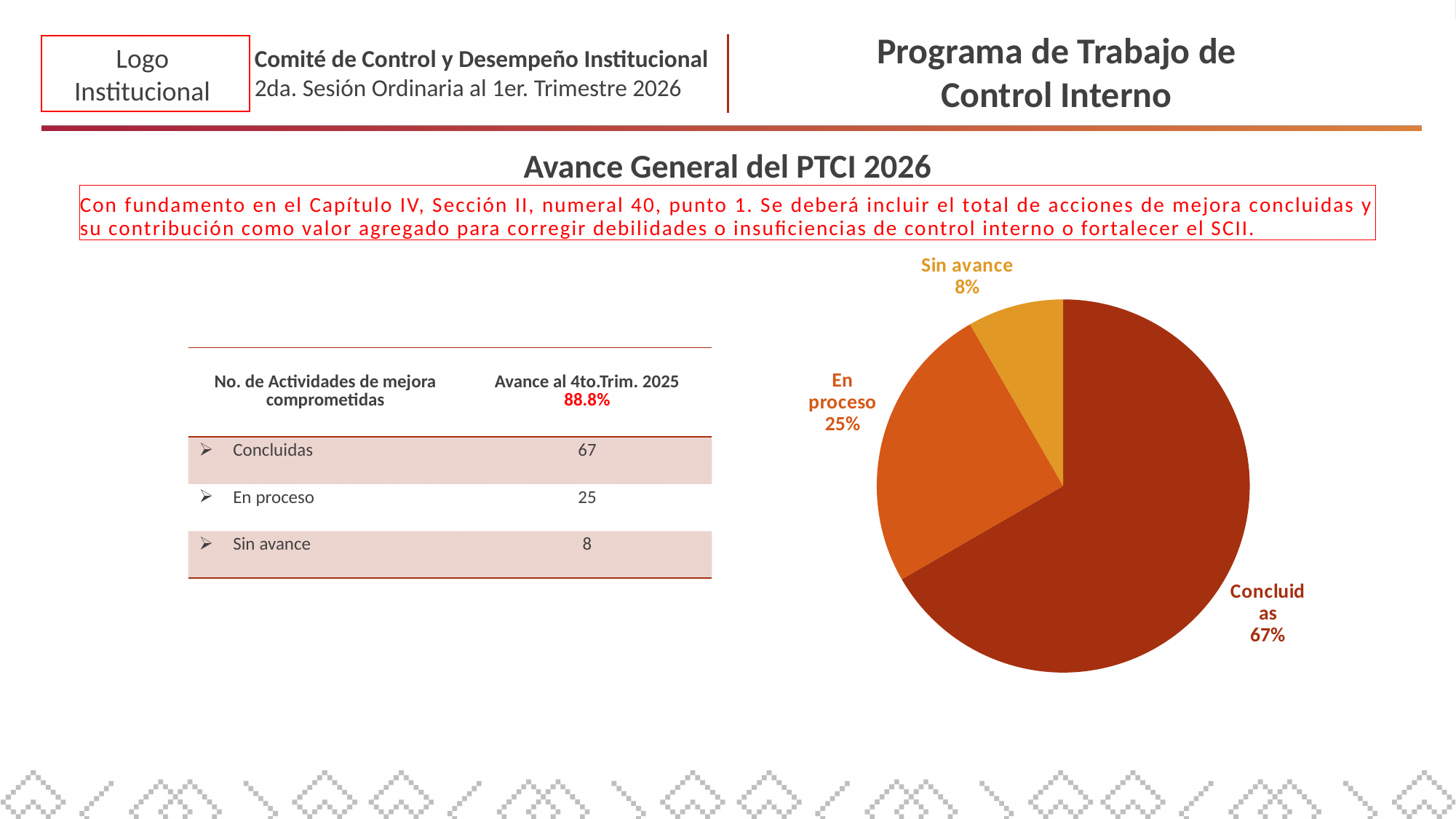
What is the difference in percentage points between the En proceso and Sin avance slices? 17 What share of the pie chart does the Sin avance slice represent? 8% What colour is the Sin avance slice in the pie chart? Yellow-orange Is the Concluidas slice greater or less than 50% of the pie? greater How many slices does the pie chart have? 3 What share of the pie chart does the Concluidas slice represent? 67% Which slice of the pie chart is the smallest? Sin avance Which slice is larger, En proceso or Sin avance? En proceso What share of the pie chart does the En proceso slice represent? 25% Which slice of the pie chart is the largest? Concluidas What is the difference in percentage points between the Concluidas and En proceso slices? 42 What kind of chart is shown on the slide? Pie chart